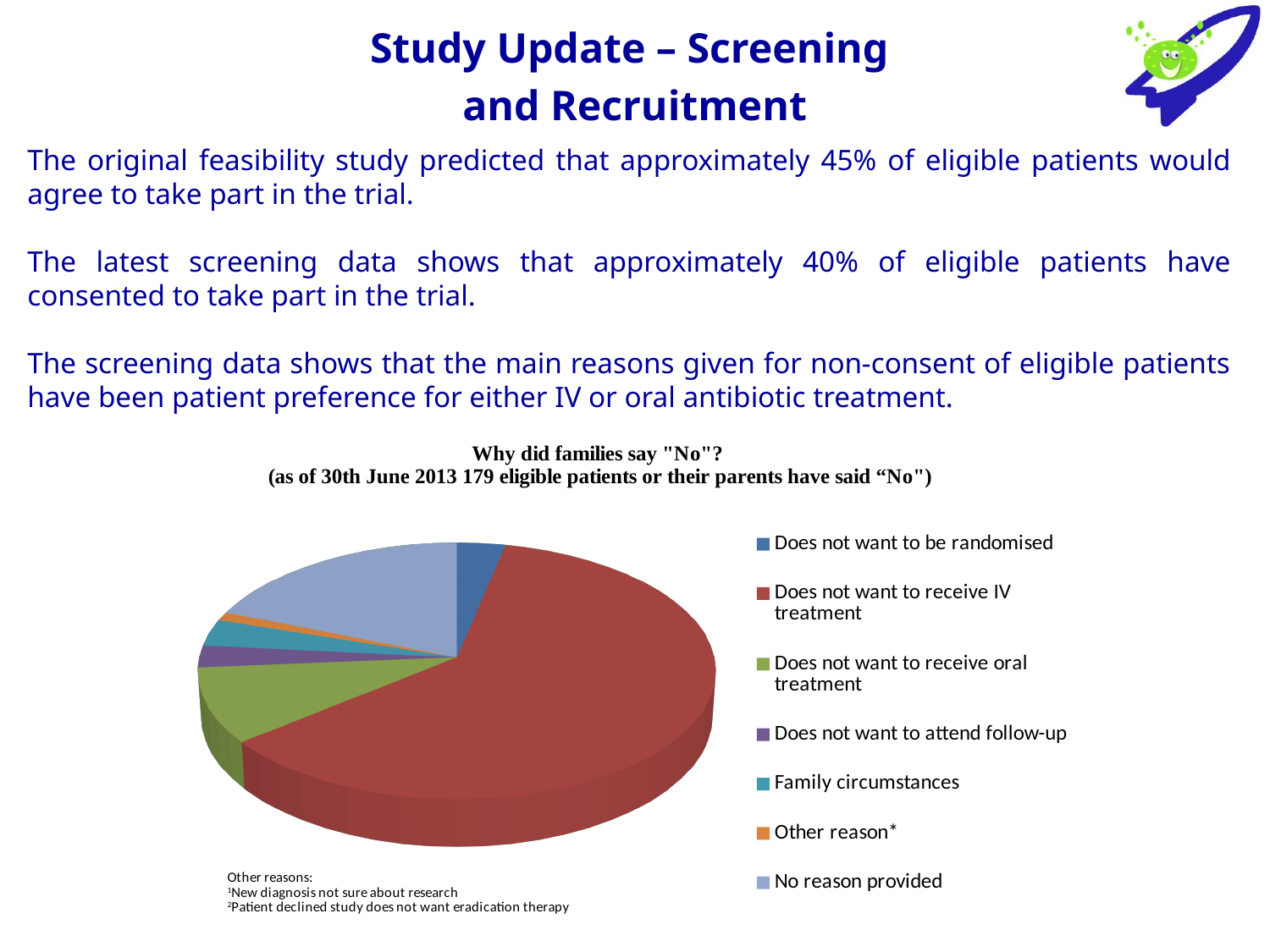
Which reason accounts for the smallest slice of the pie chart? Other reason* Which slice is larger: "Does not want to receive oral treatment" or "Does not want to attend follow-up"? Does not want to receive oral treatment Which slice is larger: "Does not want to receive IV treatment" or "Does not want to receive oral treatment"? Does not want to receive IV treatment Which slice is larger: "No reason provided" or "Does not want to receive oral treatment"? No reason provided According to the chart title, how many eligible patients or their parents had said "No" as of 30th June 2013? 179 Which reason accounts for the largest slice of the pie chart? Does not want to receive IV treatment What kind of chart is shown on the slide? Pie chart How many categories (slices) does the pie chart have? 7 What is the title of the pie chart? Why did families say "No"?